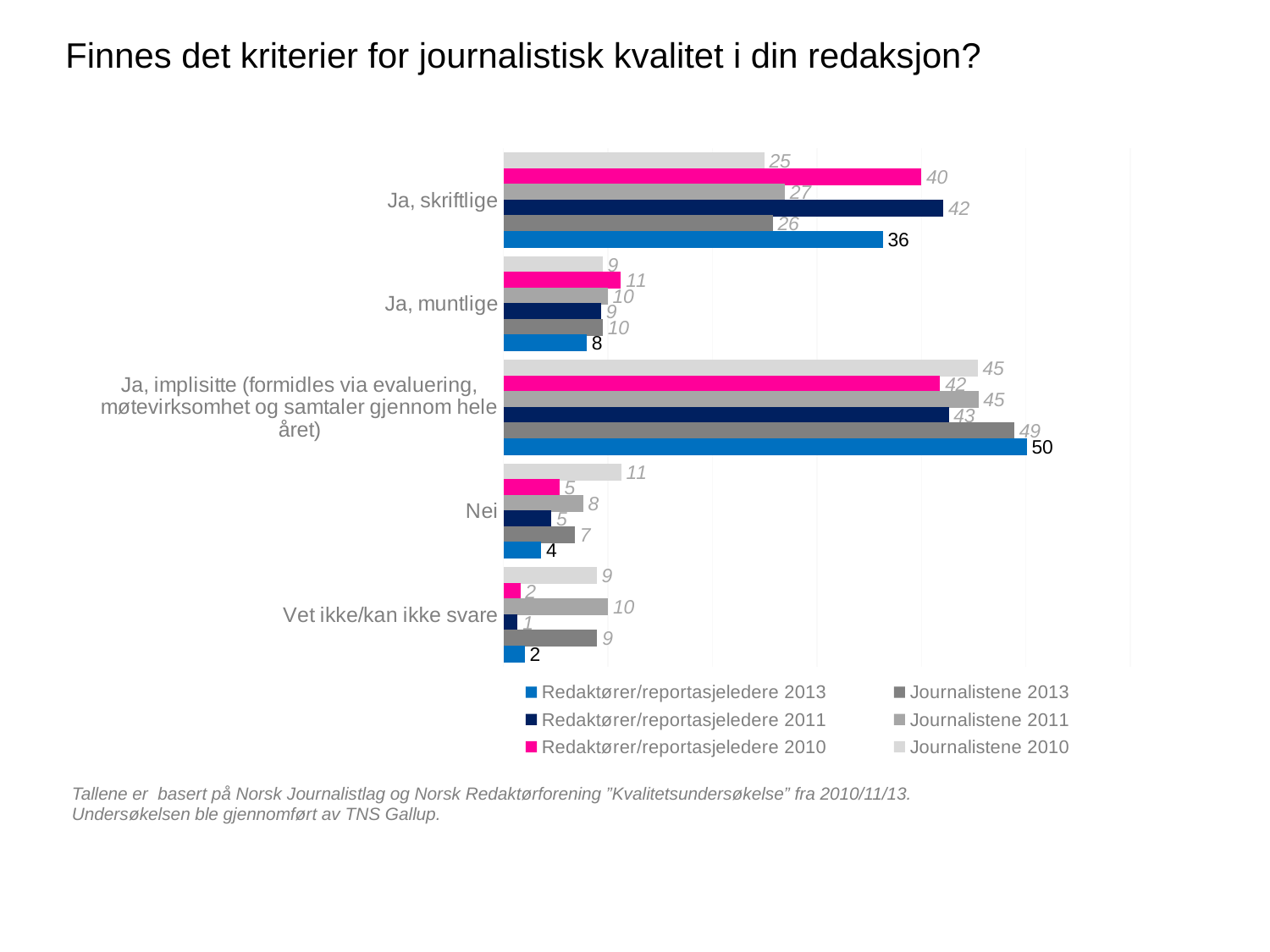
Which category has the highest value for Redaktører/reportasjeledere 2013? Ja, implisitte (formidles via evaluering, møtevirksomhet og samtaler gjennom hele året) What is the value for Redaktører/reportasjeledere 2013 in the "Ja, skriftlige" category? 36 What is the value for Journalistene 2013 in the "Ja, implisitte" category? 49 What is the value for Journalistene 2010 in the "Nei" category? 11 What kind of chart is shown on the slide? Bar chart What is the difference between Redaktører/reportasjeledere 2011 and Journalistene 2011 in the "Ja, skriftlige" category? 15 Which is larger in the "Ja, implisitte" category: Redaktører/reportasjeledere 2013 or Redaktører/reportasjeledere 2010? Redaktører/reportasjeledere 2013 Which category has the lowest value for Journalistene 2011? Nei How many categories are shown on the chart? 5 How many series does the legend list? 6 What is the value for Redaktører/reportasjeledere 2011 in the "Ja, skriftlige" category? 42 What is the value for Redaktører/reportasjeledere 2011 in the "Vet ikke/kan ikke svare" category? 1